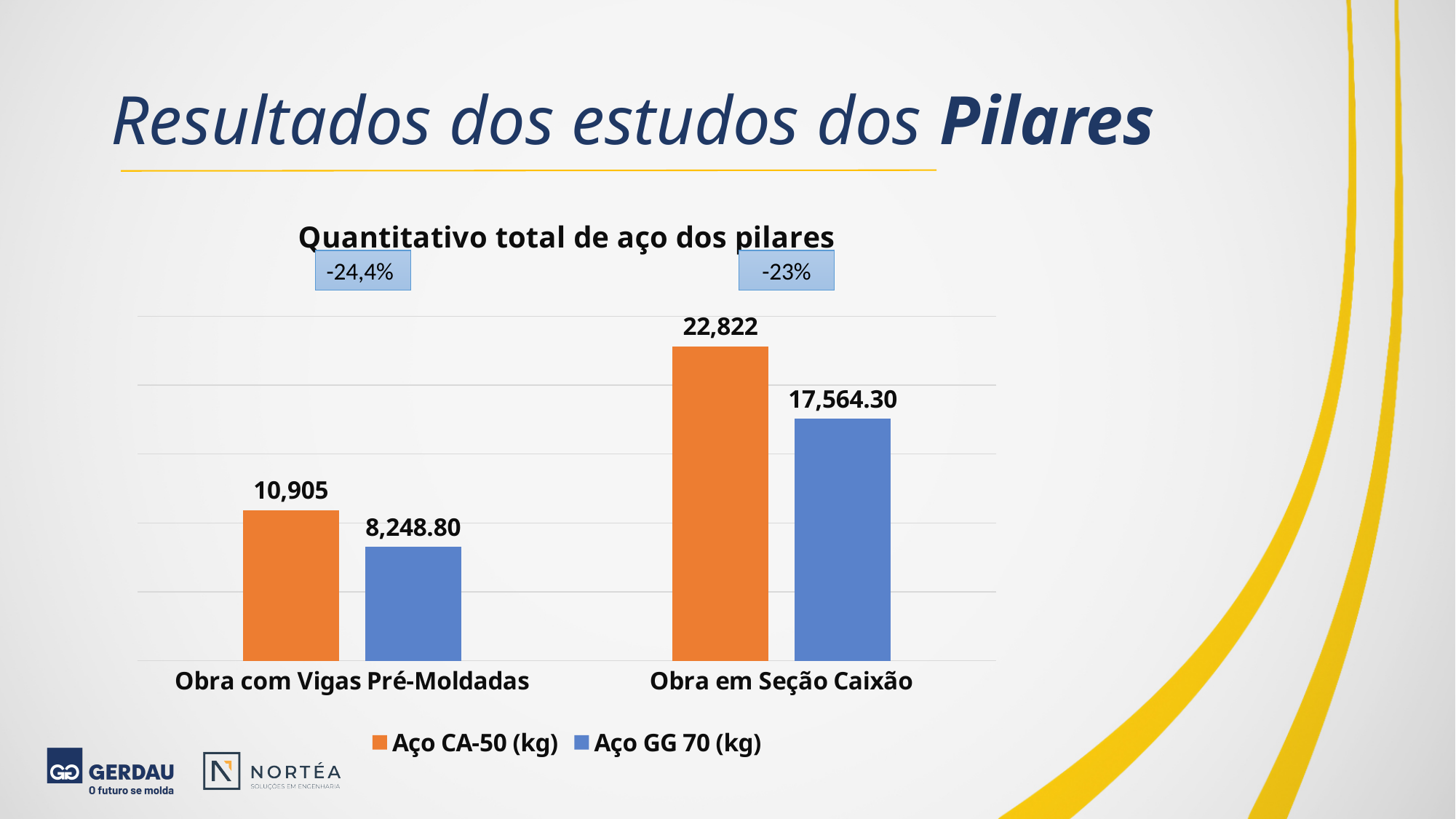
How many series does the legend list? 2 What is the value of Aço CA-50 (kg) for Obra com Vigas Pré-Moldadas? 10,905 What is the value of Aço GG 70 (kg) for Obra com Vigas Pré-Moldadas? 8,248.80 How many categories are shown on the x axis? 2 Which is larger: Aço GG 70 (kg) for Obra em Seção Caixão or Aço CA-50 (kg) for Obra com Vigas Pré-Moldadas? Aço GG 70 (kg) for Obra em Seção Caixão What is the value of Aço CA-50 (kg) for Obra em Seção Caixão? 22,822 Which bar has the lowest value in the chart? Aço GG 70 (kg) for Obra com Vigas Pré-Moldadas What is the value of Aço GG 70 (kg) for Obra em Seção Caixão? 17,564.30 What type of chart is shown on the slide? Bar chart What is the difference between Aço CA-50 (kg) and Aço GG 70 (kg) for Obra em Seção Caixão? 5,257.70 Which bar has the highest value in the chart? Aço CA-50 (kg) for Obra em Seção Caixão What is the difference between Aço CA-50 (kg) and Aço GG 70 (kg) for Obra com Vigas Pré-Moldadas? 2,656.20